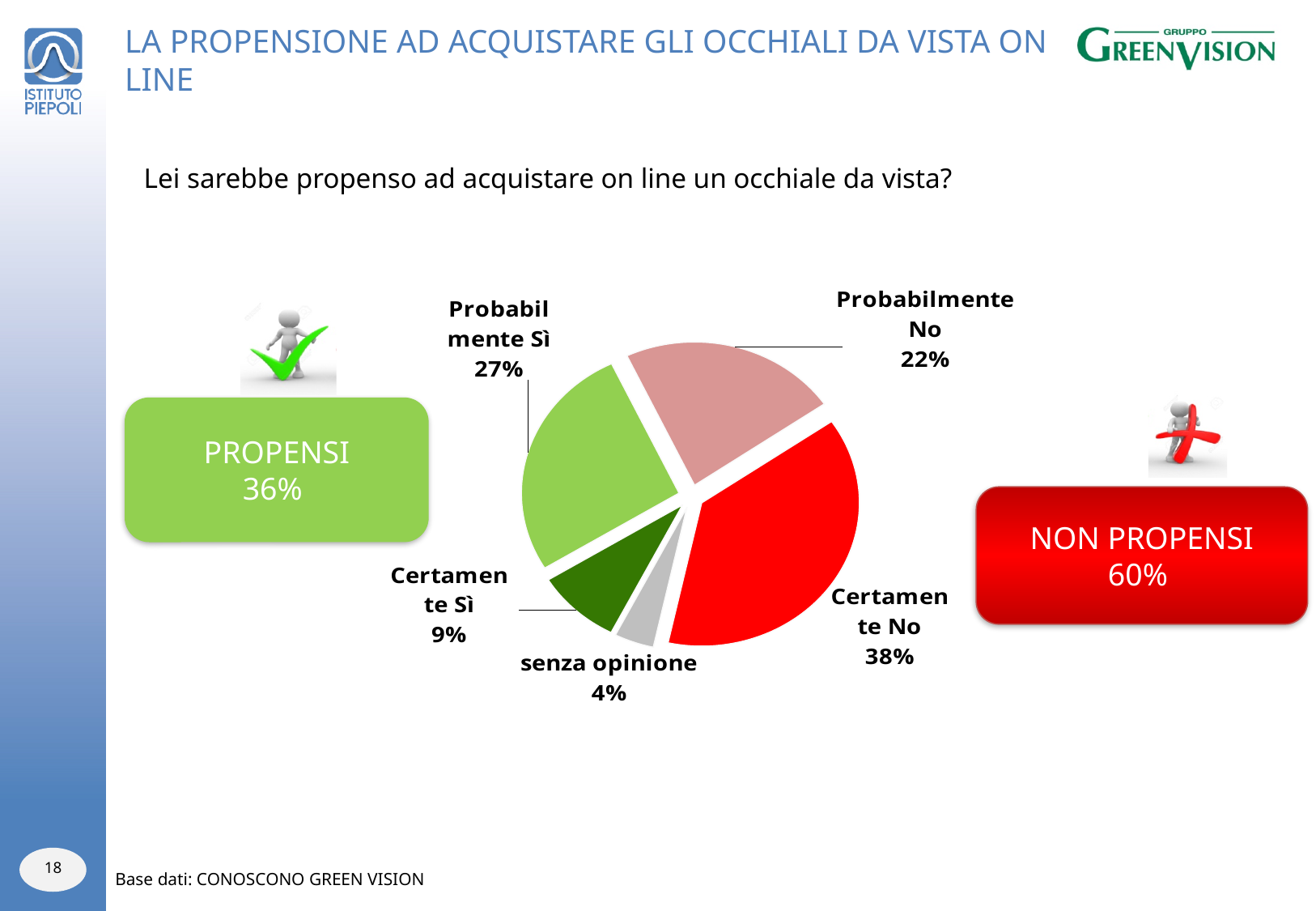
Which response has the largest share of the pie? Certamente No What colour is the "Certamente No" slice? red What percentage of respondents answered "Probabilmente Sì"? 27% Which response has the smallest share of the pie? senza opinione What percentage of respondents are "senza opinione"? 4% How many slices does the pie chart have? 5 What percentage of respondents answered "Certamente Sì"? 9% What percentage of respondents answered "Probabilmente No"? 22% What kind of chart is shown on the slide? pie chart Which is larger, the share for "Probabilmente Sì" or the share for "Probabilmente No"? Probabilmente Sì What is the difference in percentage points between "Certamente No" and "Certamente Sì"? 29 What percentage of respondents answered "Certamente No"? 38%